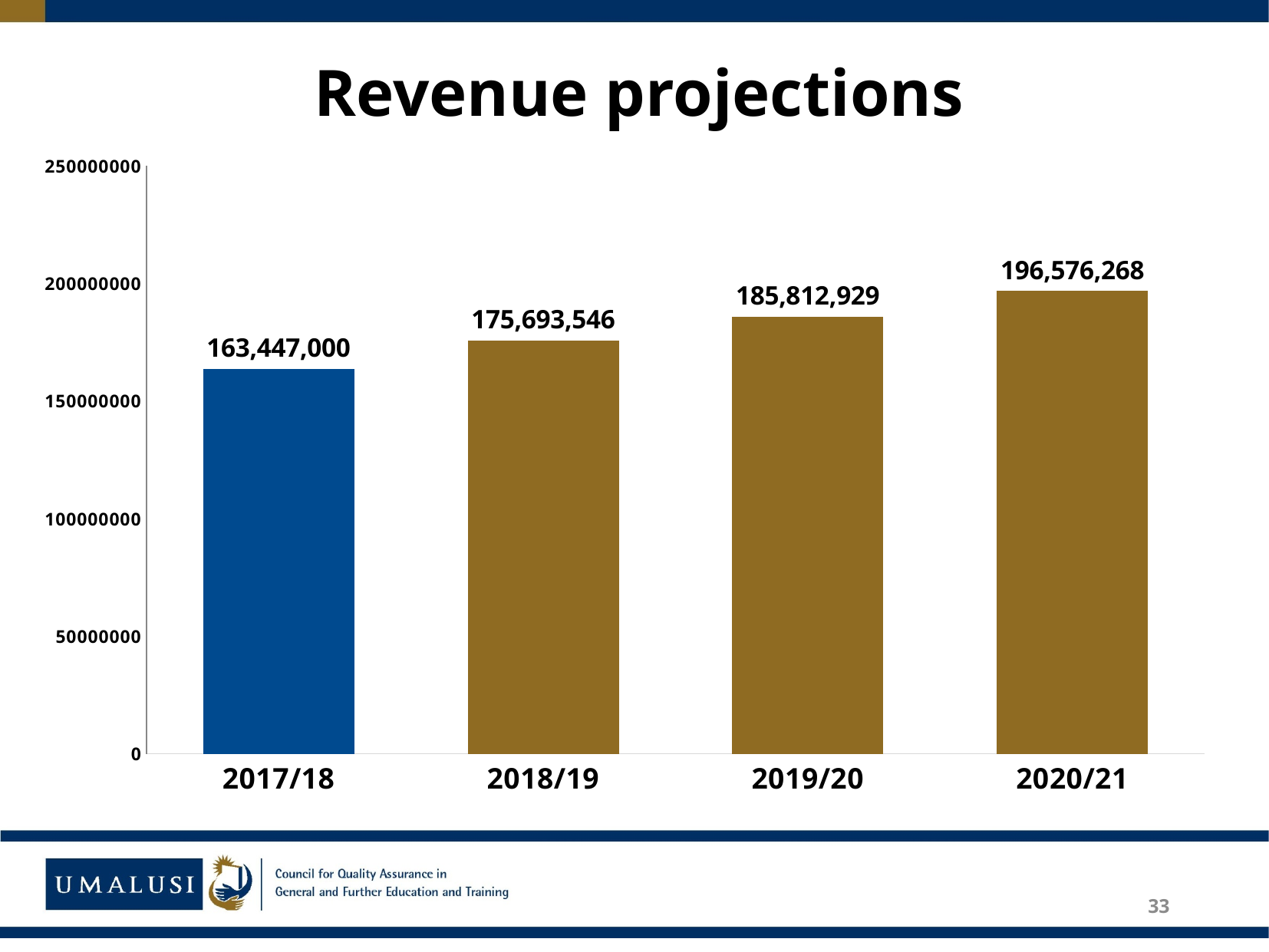
What is the revenue projection for 2020/21? 196,576,268 What is the revenue projection for 2017/18? 163,447,000 Is the revenue projection for 2020/21 greater or less than 200000000? less What is the difference between the revenue projections for 2020/21 and 2017/18? 33,129,268 Which year has the lowest revenue projection? 2017/18 Do the revenue projections rise or fall from 2017/18 to 2020/21? rise Which is larger, the revenue projection for 2018/19 or for 2019/20? 2019/20 Which year has the highest revenue projection? 2020/21 What kind of chart is shown on the slide? bar chart What is the revenue projection for 2019/20? 185,812,929 What is the difference between the revenue projections for 2018/19 and 2017/18? 12,246,546 How many years are shown on the chart? 4